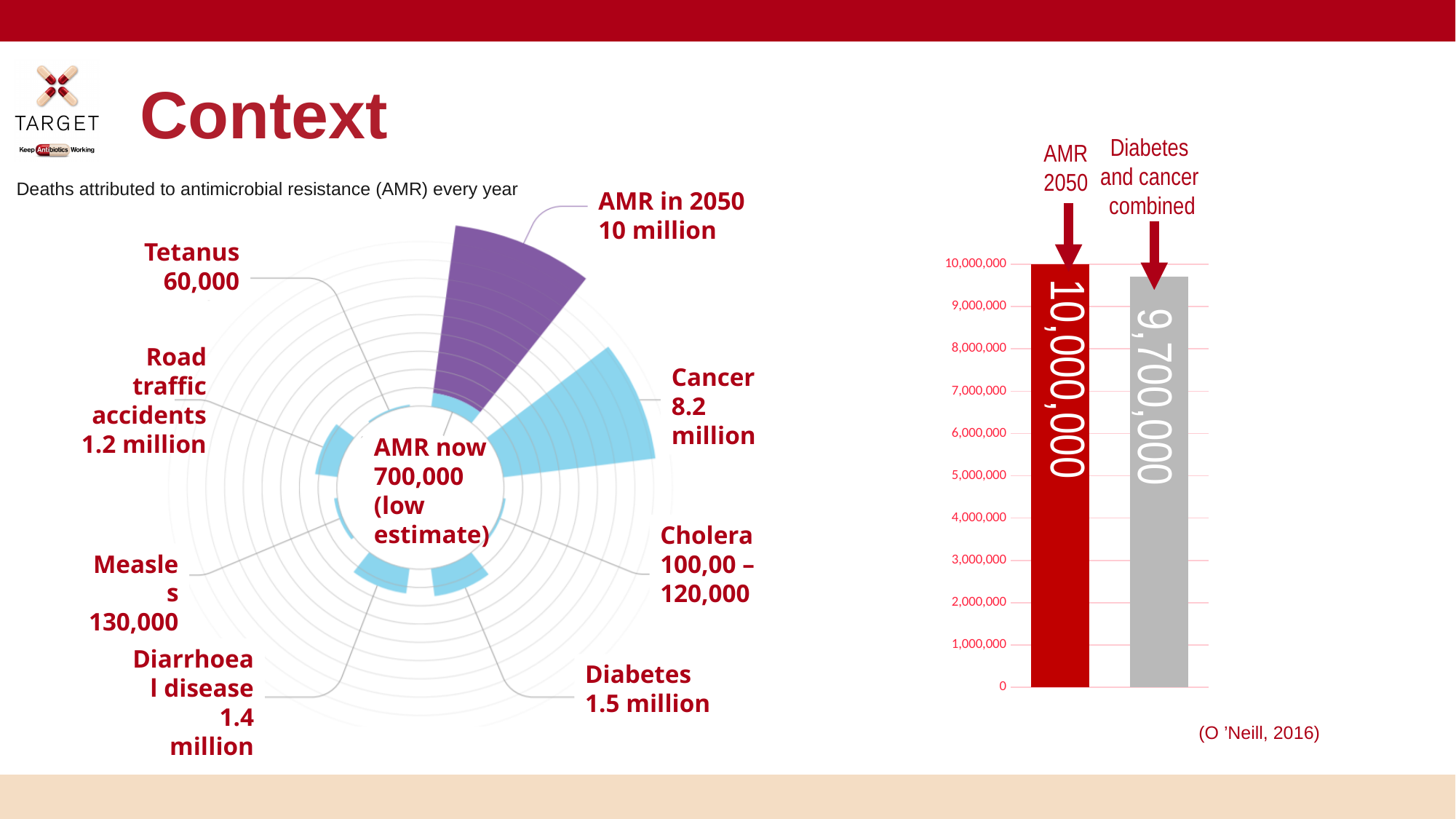
In the chart on the left titled 'Deaths attributed to antimicrobial resistance (AMR) every year', what value is given for Cancer? 8.2 million What type of chart is shown on the right side of the slide? Bar chart In the chart on the left titled 'Deaths attributed to antimicrobial resistance (AMR) every year', which category has the highest value? AMR in 2050 In the chart on the left titled 'Deaths attributed to antimicrobial resistance (AMR) every year', what is the value labelled for AMR now? 700,000 (low estimate) In the bar chart on the right, how many bars are plotted? 2 In the bar chart on the right, which bar is taller: AMR 2050 or Diabetes and cancer combined? AMR 2050 In the chart on the left titled 'Deaths attributed to antimicrobial resistance (AMR) every year', what value is given for Tetanus? 60,000 In the bar chart on the right, what value is shown for AMR 2050? 10,000,000 In the chart on the left titled 'Deaths attributed to antimicrobial resistance (AMR) every year', which category has the lowest value? Tetanus In the bar chart on the right, is the value for Diabetes and cancer combined greater or less than 9,000,000? greater In the bar chart on the right, what value is shown for Diabetes and cancer combined? 9,700,000 In the bar chart on the right, what is the difference between the AMR 2050 bar and the Diabetes and cancer combined bar? 300,000